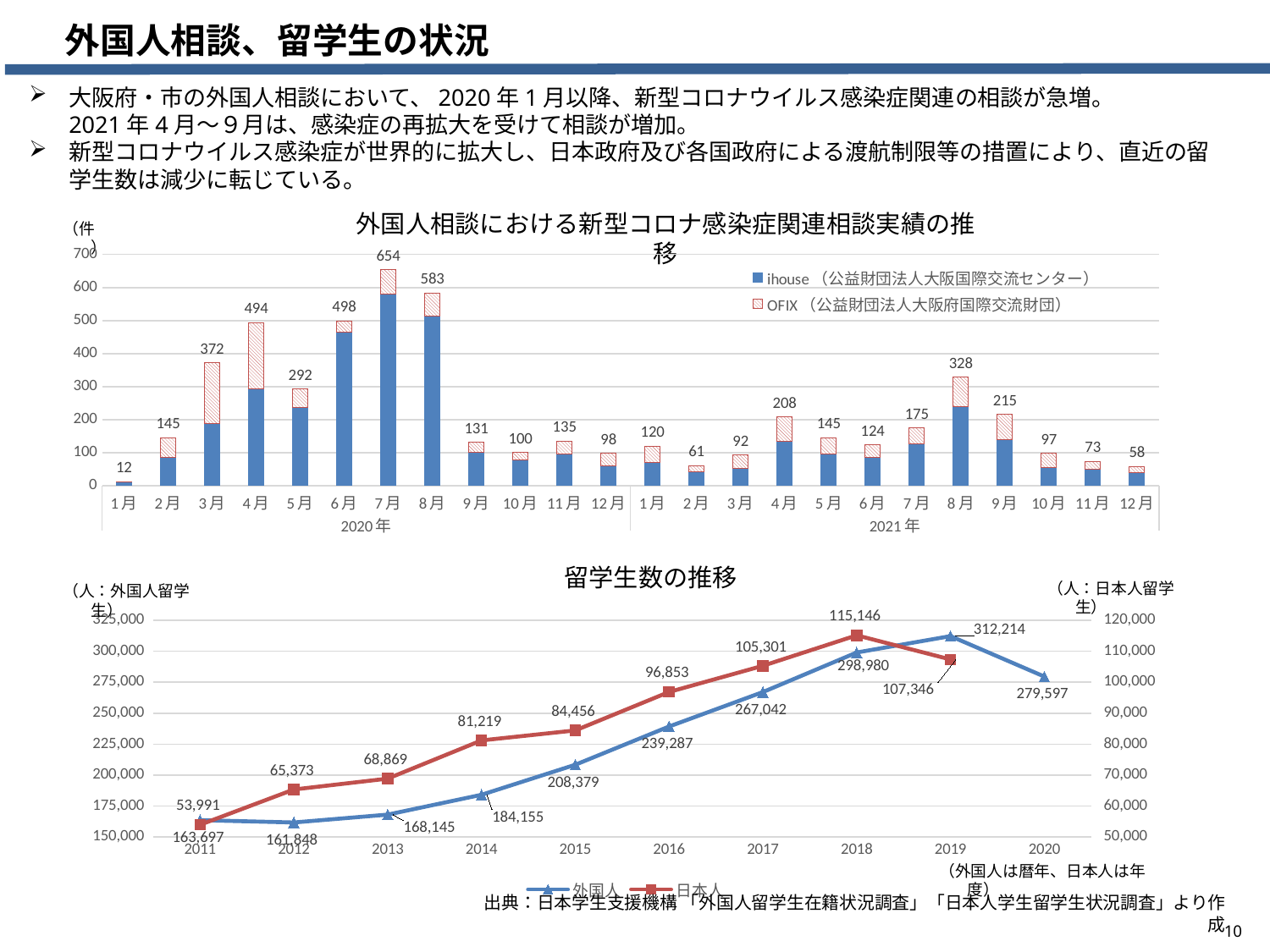
In the bottom chart 「留学生数の推移」, in which year is the 日本人 series highest? 2018 What kind of chart is the top chart titled 「外国人相談における新型コロナ感染症関連相談実績の推移」? bar chart In the top chart 「外国人相談における新型コロナ感染症関連相談実績の推移」, what is the difference between the totals for 2020年7月 and 2020年8月? 71 In the top chart 「外国人相談における新型コロナ感染症関連相談実績の推移」, what is the total number of consultations for 2021年8月? 328 In the bottom chart 「留学生数の推移」, what is the value for 日本人 in 2018? 115,146 In the bottom chart 「留学生数の推移」, what is the value for 外国人 in 2019? 312,214 What kind of chart is the bottom chart titled 「留学生数の推移」? line chart How many series does the legend of the top chart 「外国人相談における新型コロナ感染症関連相談実績の推移」 list? 2 In the bottom chart 「留学生数の推移」, which is larger for 外国人: the value in 2012 or the value in 2013? 2013 In the top chart 「外国人相談における新型コロナ感染症関連相談実績の推移」, which month has the highest total number of consultations? 2020年7月 In the bottom chart 「留学生数の推移」, what is the difference between the 外国人 values for 2019 and 2020? 32,617 In the top chart 「外国人相談における新型コロナ感染症関連相談実績の推移」, which month has the lowest total number of consultations? 2020年1月